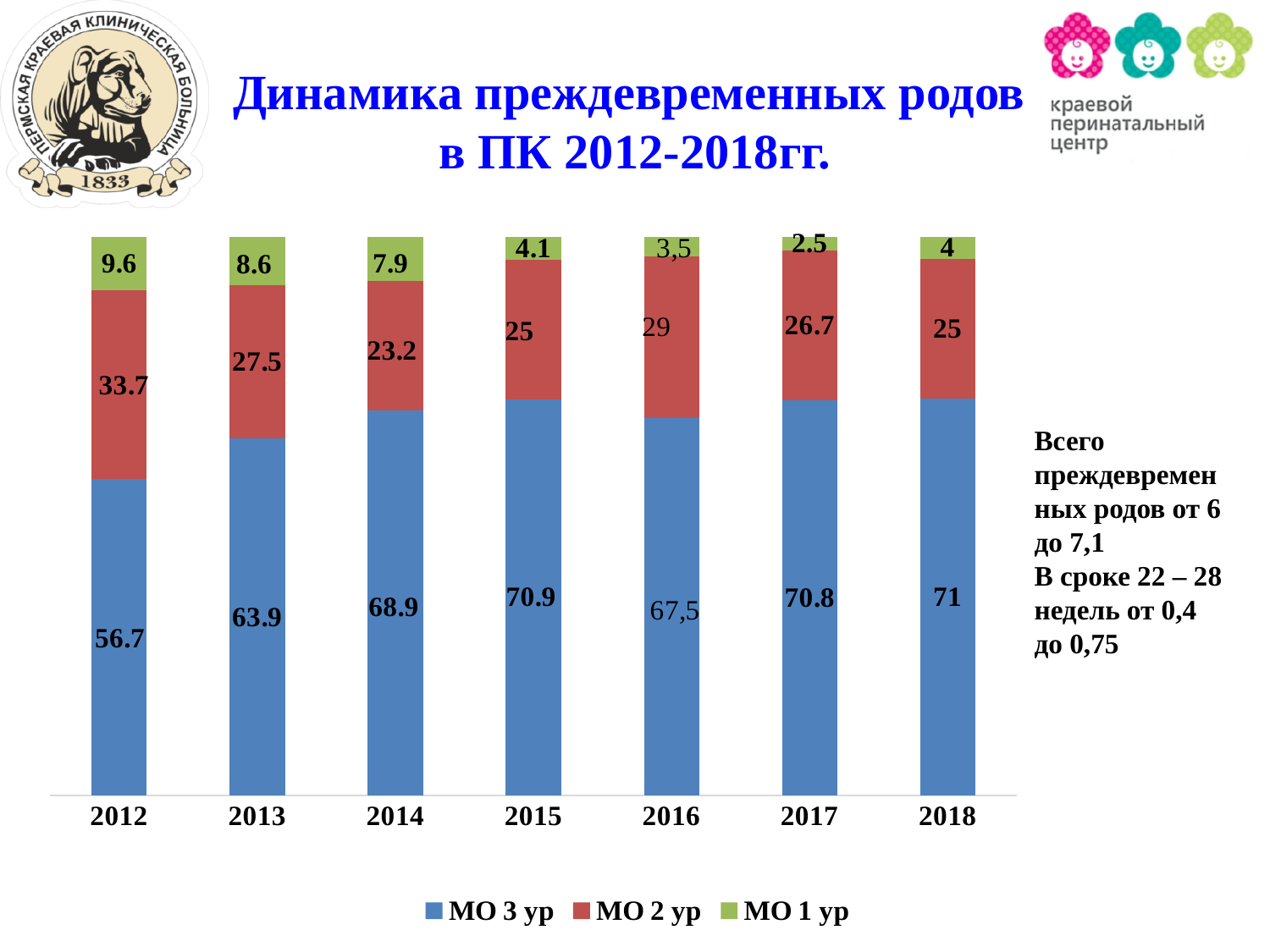
In which year is the value of МО 1 ур the lowest? 2017 What is the value of МО 1 ур in 2017? 2.5 What is the total of the stacked bar for 2013? 100 Does the value of МО 1 ур generally rise or fall from 2012 to 2018? Fall How many years are shown on the x axis? 7 What is the difference between the МО 2 ур values in 2012 and 2014? 10.5 What is the value of МО 3 ур in 2012? 56.7 Which is larger: МО 1 ур in 2013 or МО 1 ур in 2015? МО 1 ур in 2013 In which year is the value of МО 3 ур the highest? 2018 What is the value of МО 2 ур in 2016? 29 What type of chart is shown on the slide? Stacked bar chart How many series does the legend list? 3